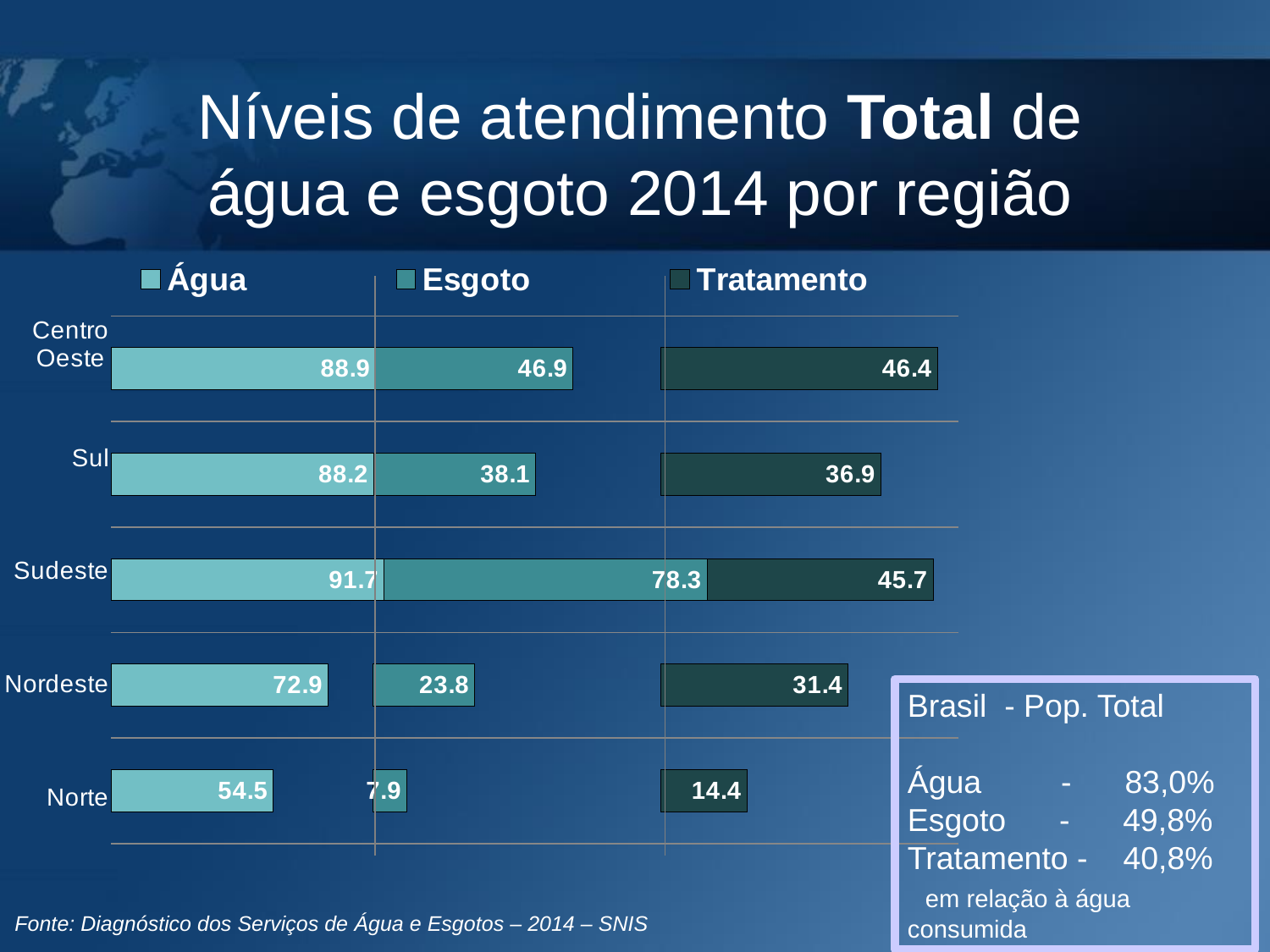
Which is larger, the Tratamento value for Centro Oeste or for Sudeste? Centro Oeste What is the difference between the Água values for Centro Oeste and Nordeste? 16.0 Which region has the highest Esgoto value? Sudeste What is the difference between the Esgoto values for Sudeste and Sul? 40.2 Which region has the lowest Água value? Norte What is the Tratamento value for Norte? 14.4 Which region has the lowest Tratamento value? Norte What is the Esgoto value for Nordeste? 23.8 How many series does the legend list? 3 How many regions are shown in the chart? 5 What is the Água value for Sudeste? 91.7 What kind of chart is shown on the slide? Bar chart